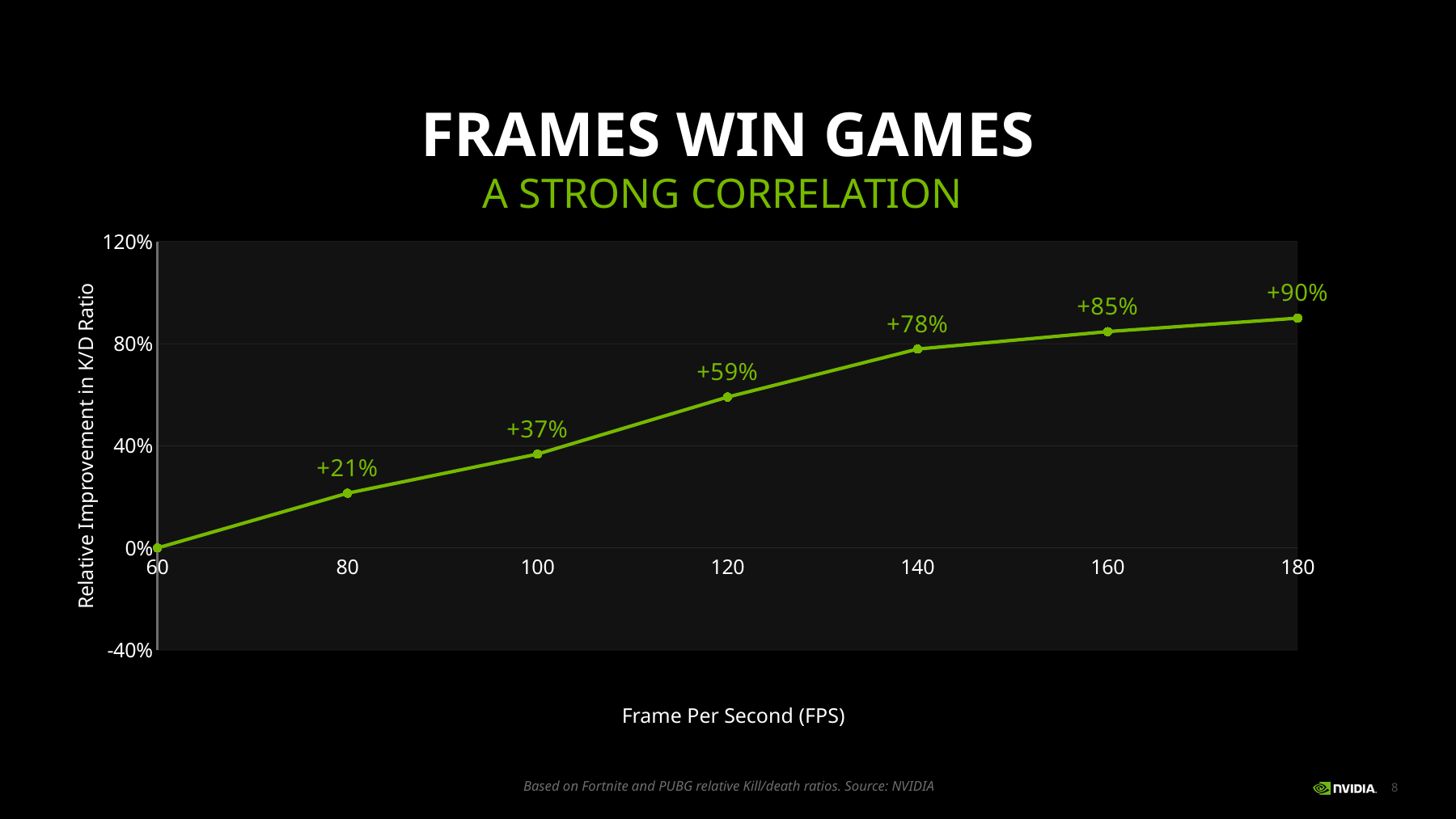
At which FPS value is the relative improvement in K/D ratio highest? 180 How many data points are plotted on the line? 7 At which FPS value is the relative improvement in K/D ratio lowest? 60 What is the difference in relative improvement between 140 FPS and 100 FPS? 41% Is the relative improvement at 140 FPS greater or less than 80%? less What is the relative improvement in K/D ratio at 80 FPS? +21% Does the relative improvement in K/D ratio rise or fall as FPS increases? rise What is the label of the x axis? Frame Per Second (FPS) What kind of chart is shown on the slide? line chart What is the relative improvement in K/D ratio at 180 FPS? +90% What is the relative improvement in K/D ratio at 120 FPS? +59% Which has a larger relative improvement in K/D ratio, 160 FPS or 120 FPS? 160 FPS